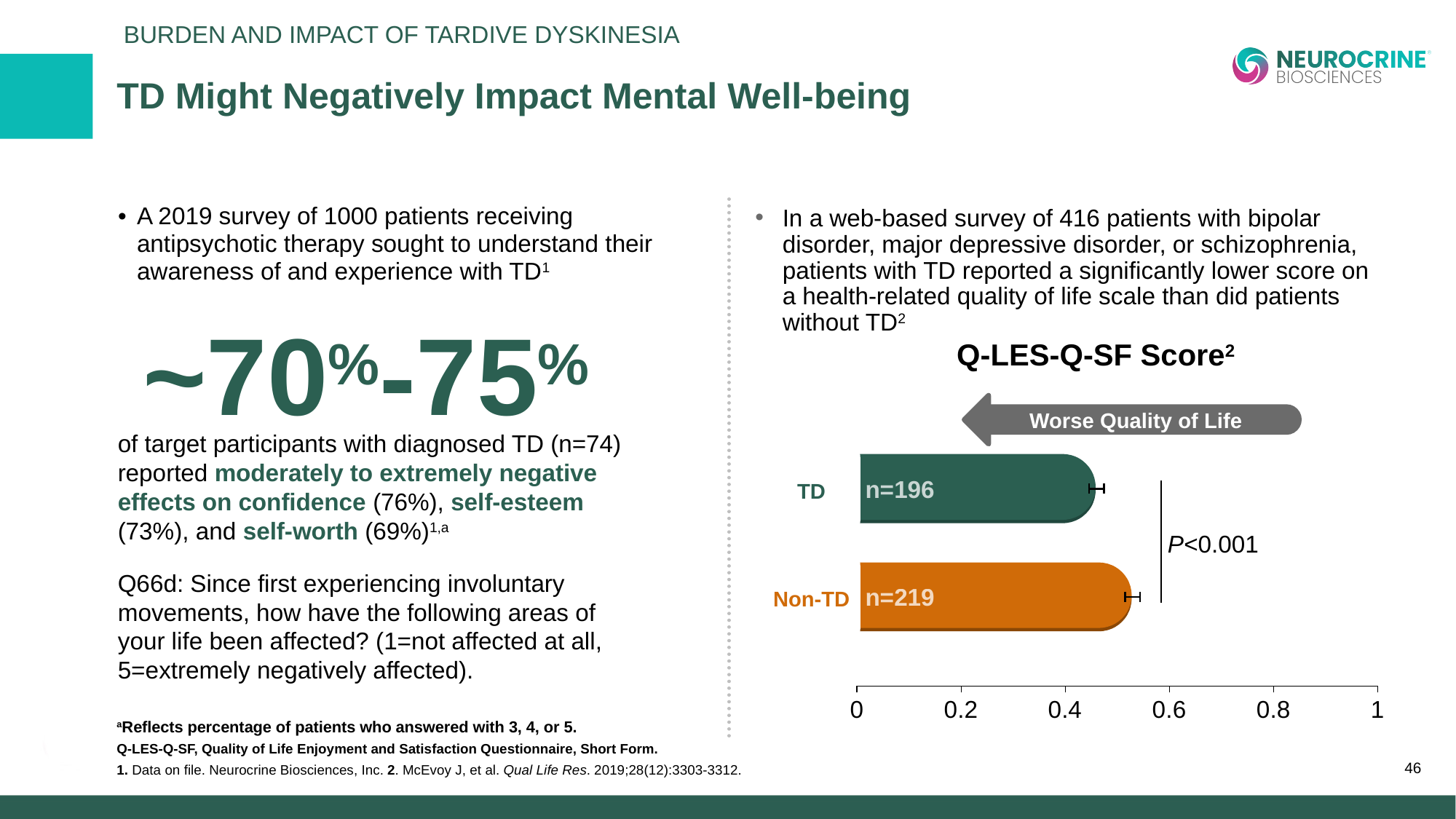
Is the Q-LES-Q-SF Score for Non-TD greater or less than 0.6? less What kind of chart is shown under the title Q-LES-Q-SF Score? bar chart Which category has the highest bar in the Q-LES-Q-SF Score chart? Non-TD Is the Q-LES-Q-SF Score for TD greater or less than 0.6? less Which category has the higher Q-LES-Q-SF Score, TD or Non-TD? Non-TD Which category has the lowest bar in the Q-LES-Q-SF Score chart? TD How many categories are plotted in the Q-LES-Q-SF Score chart? 2 What sample size (n) is printed on the TD bar in the Q-LES-Q-SF Score chart? n=196 What P value is shown between the two bars in the Q-LES-Q-SF Score chart? P<0.001 What sample size (n) is printed on the Non-TD bar in the Q-LES-Q-SF Score chart? n=219 Is the Q-LES-Q-SF Score for Non-TD greater or less than 0.4? greater